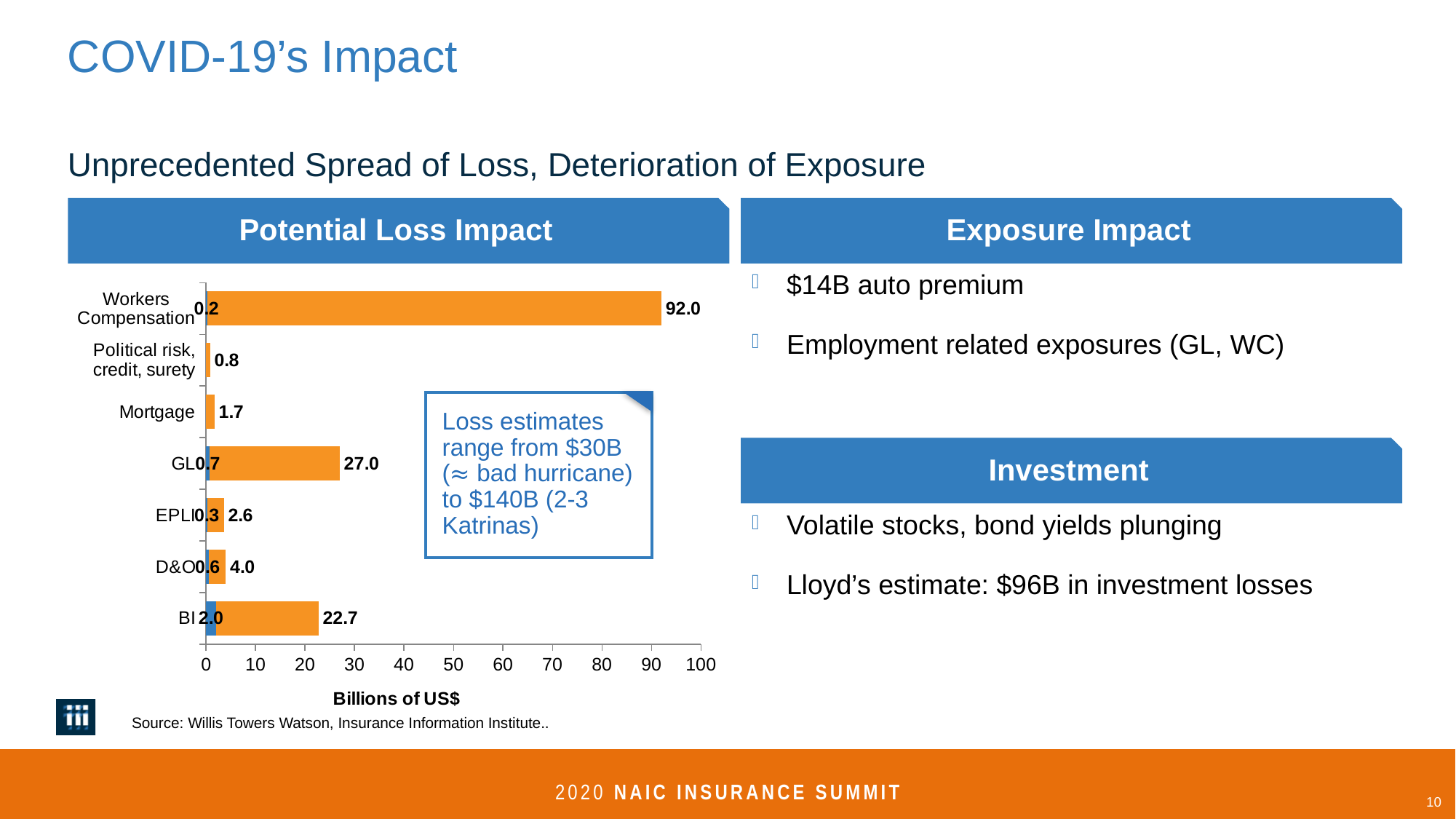
In the Potential Loss Impact chart, what is the value of the orange bar for Workers Compensation? 92.0 What unit is shown on the x axis of the Potential Loss Impact chart? Billions of US$ In the Potential Loss Impact chart, what is the difference between the orange-bar values for GL and BI? 4.3 In the Potential Loss Impact chart, what is the value of the orange bar for D&O? 4.0 In the Potential Loss Impact chart, which has the larger orange-bar value, EPLI or D&O? D&O What type of chart is shown under "Potential Loss Impact"? bar chart How many categories are plotted in the Potential Loss Impact chart? 7 In the Potential Loss Impact chart, what is the value of the orange bar for BI? 22.7 In the Potential Loss Impact chart, is the orange-bar value for Workers Compensation greater or less than 90? greater In the Potential Loss Impact chart, what is the value labelled for Mortgage? 1.7 In the Potential Loss Impact chart, what is the value of the orange bar for GL? 27.0 In the Potential Loss Impact chart, which category has the highest orange-bar value? Workers Compensation